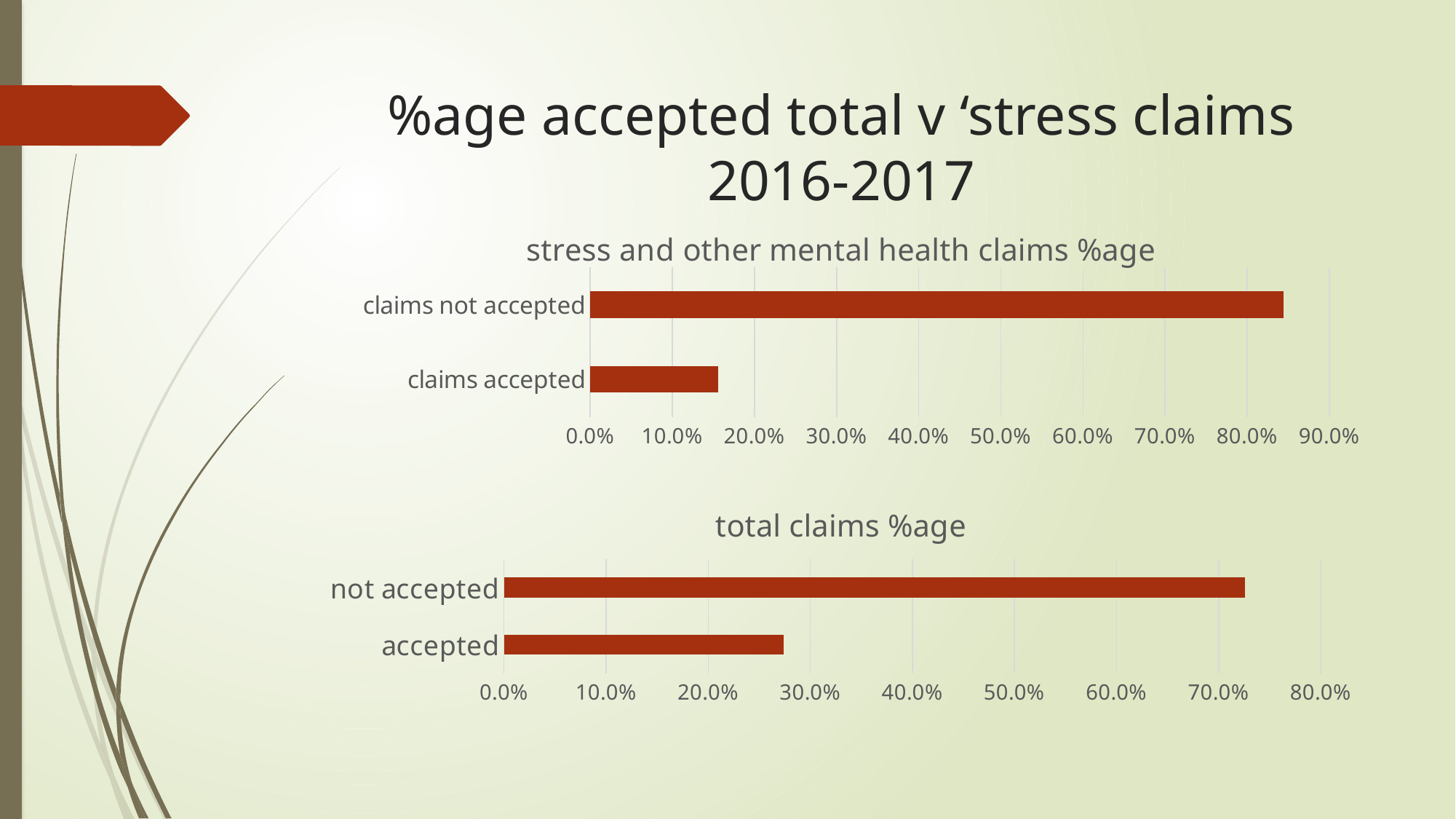
In the 'total claims %age' chart, which category has the highest value? not accepted In the 'stress and other mental health claims %age' chart, which category has the lowest value? claims accepted In the 'total claims %age' chart, is the value for accepted greater or less than 20.0%? greater What type of chart is the 'stress and other mental health claims %age' chart? bar chart In the 'stress and other mental health claims %age' chart, is the value for claims accepted greater or less than 20.0%? less In the 'stress and other mental health claims %age' chart, is the value for claims accepted greater or less than 10.0%? greater How many categories does the 'total claims %age' chart show? 2 In the 'total claims %age' chart, which is larger: accepted or not accepted? not accepted In the 'stress and other mental health claims %age' chart, which category has the highest value? claims not accepted